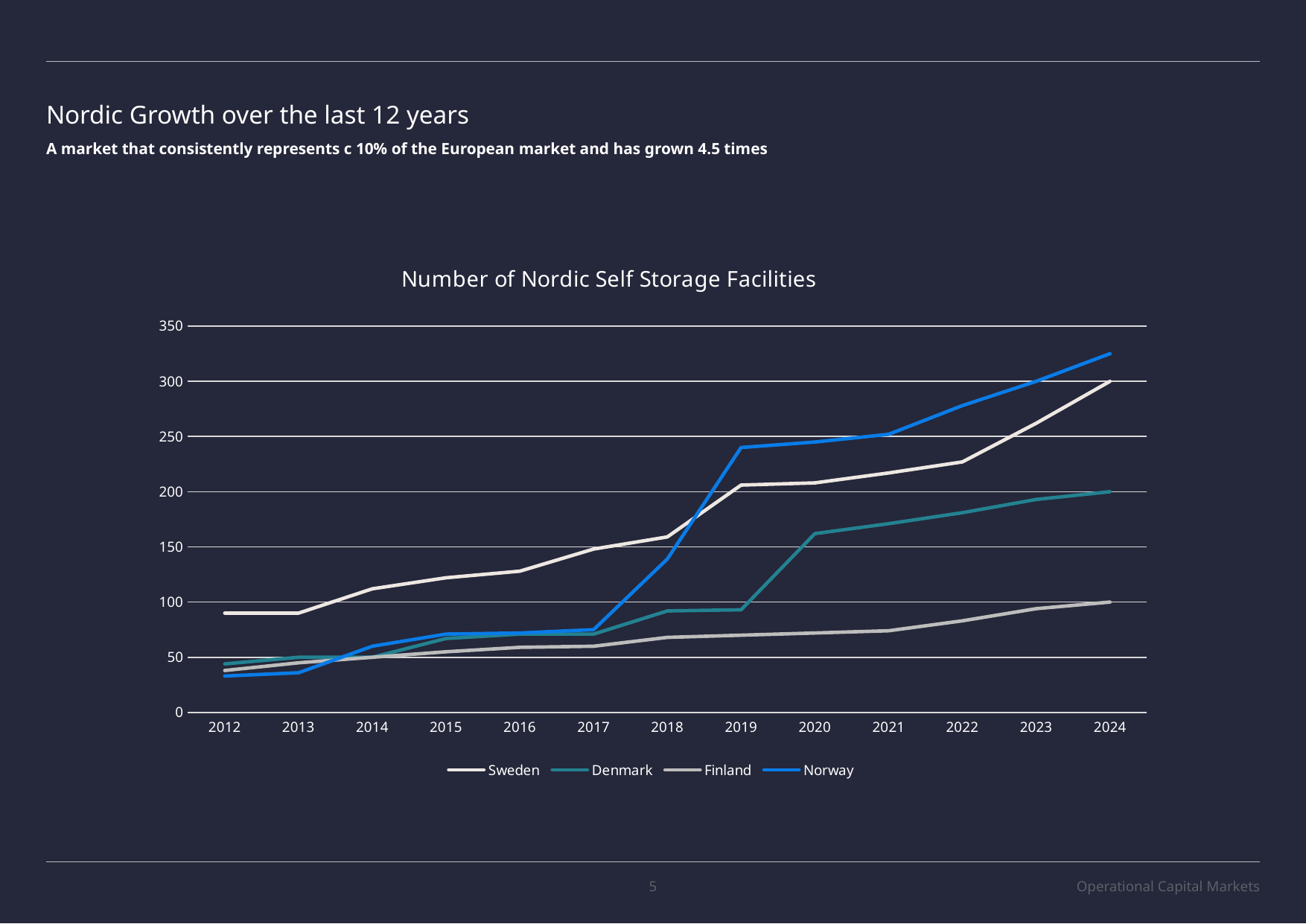
In 2019, which is larger: the value for Norway or the value for Sweden? Norway Which country has the lowest number of facilities in 2024? Finland Is the value for Sweden in 2012 greater or less than 100? less How many years are shown on the x axis? 13 Which country has the highest number of facilities in 2024? Norway What is the value for Sweden in 2024? 300 Is the value for Norway in 2024 greater or less than 300? greater Does the Sweden line rise or fall from 2012 to 2024? rise How many series does the legend list? 4 What is the title of the chart? Number of Nordic Self Storage Facilities What is the value for Finland in 2024? 100 What kind of chart is shown on the slide? line chart